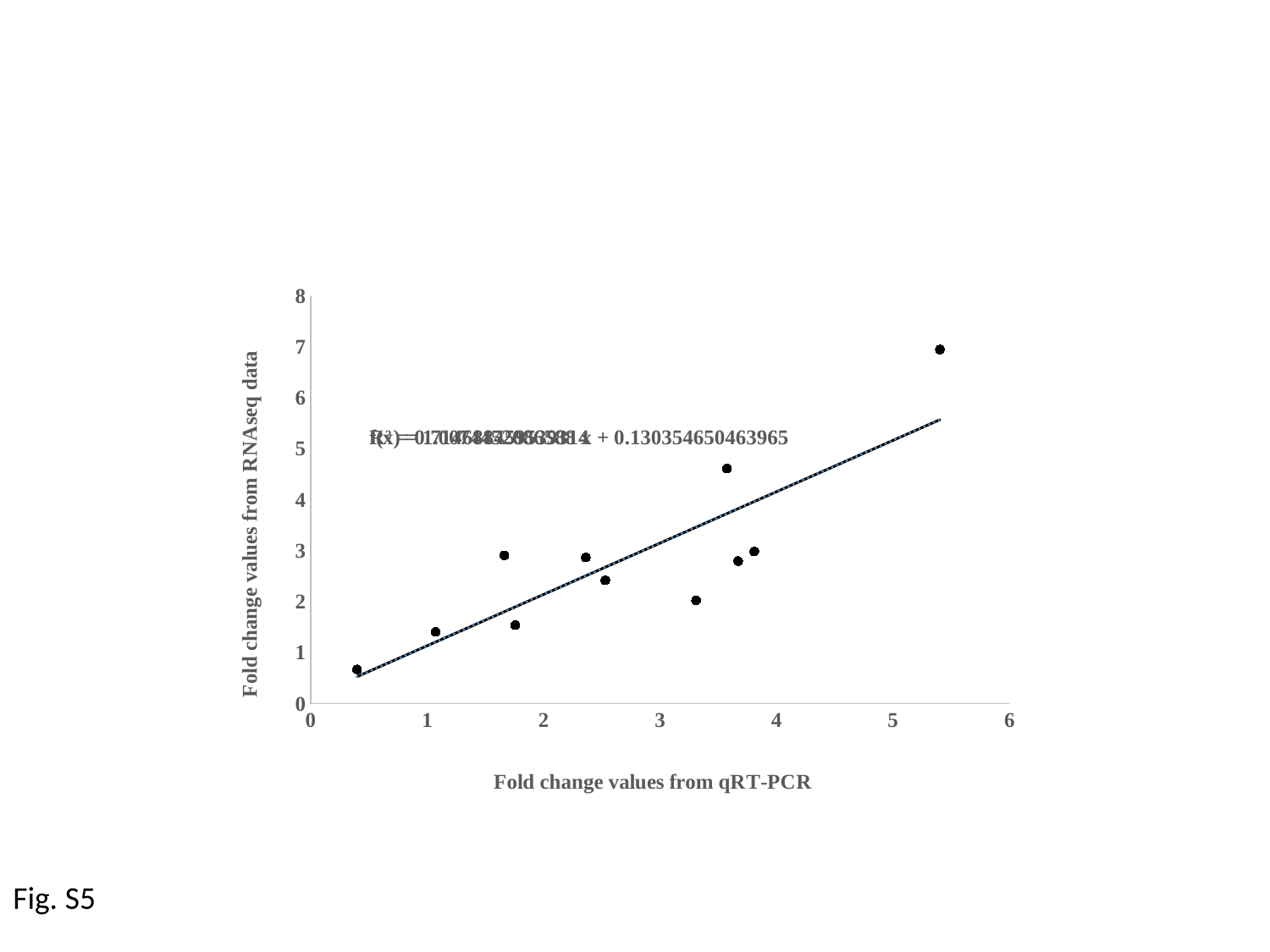
What is the maximum value shown on the y axis? 8 Is the RNAseq fold change value of the point with qRT-PCR value between 3 and 4 that lies highest greater or less than 4? greater What kind of chart is shown on the slide? scatter plot What is the title of the x axis? Fold change values from qRT-PCR Is the RNAseq fold change value of the rightmost data point greater or less than 6? greater Is the RNAseq fold change value of the point with qRT-PCR value just above 3 greater or less than 3? less Do the RNAseq fold change values generally rise or fall as the qRT-PCR fold change values increase? rise Which data point has the highest RNAseq fold change value: the one with the largest qRT-PCR value or the one with the smallest qRT-PCR value? the one with the largest qRT-PCR value How many data points are plotted on the chart? 11 What is the title of the y axis? Fold change values from RNAseq data